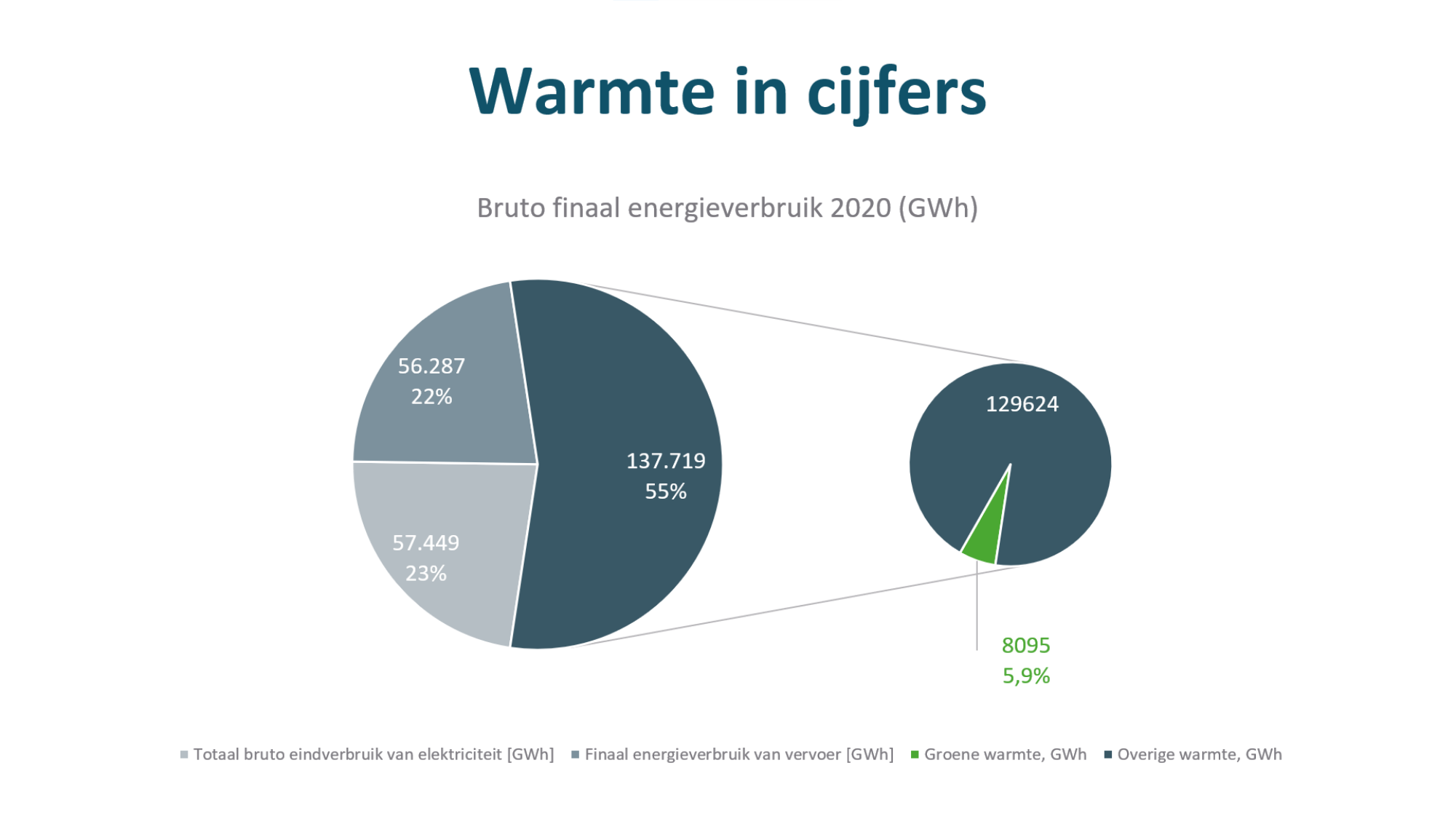
What is the value for Overige warmte? 129624 How many entries does the legend list? 4 What is the value for Totaal bruto eindverbruik van elektriciteit? 57.449 What percentage share is shown for Groene warmte? 5,9% What percentage share is shown for Finaal energieverbruik van vervoer? 22% What is the value of the largest slice in the main pie? 137.719 What is the title of the chart? Bruto finaal energieverbruik 2020 (GWh) What is the difference between the value for Totaal bruto eindverbruik van elektriciteit (57.449) and Finaal energieverbruik van vervoer (56.287)? 1.162 What is the value for Groene warmte? 8095 What kind of chart is shown on the slide? pie chart What percentage share does the largest slice of the main pie have? 55% Which is larger, Overige warmte or Groene warmte? Overige warmte